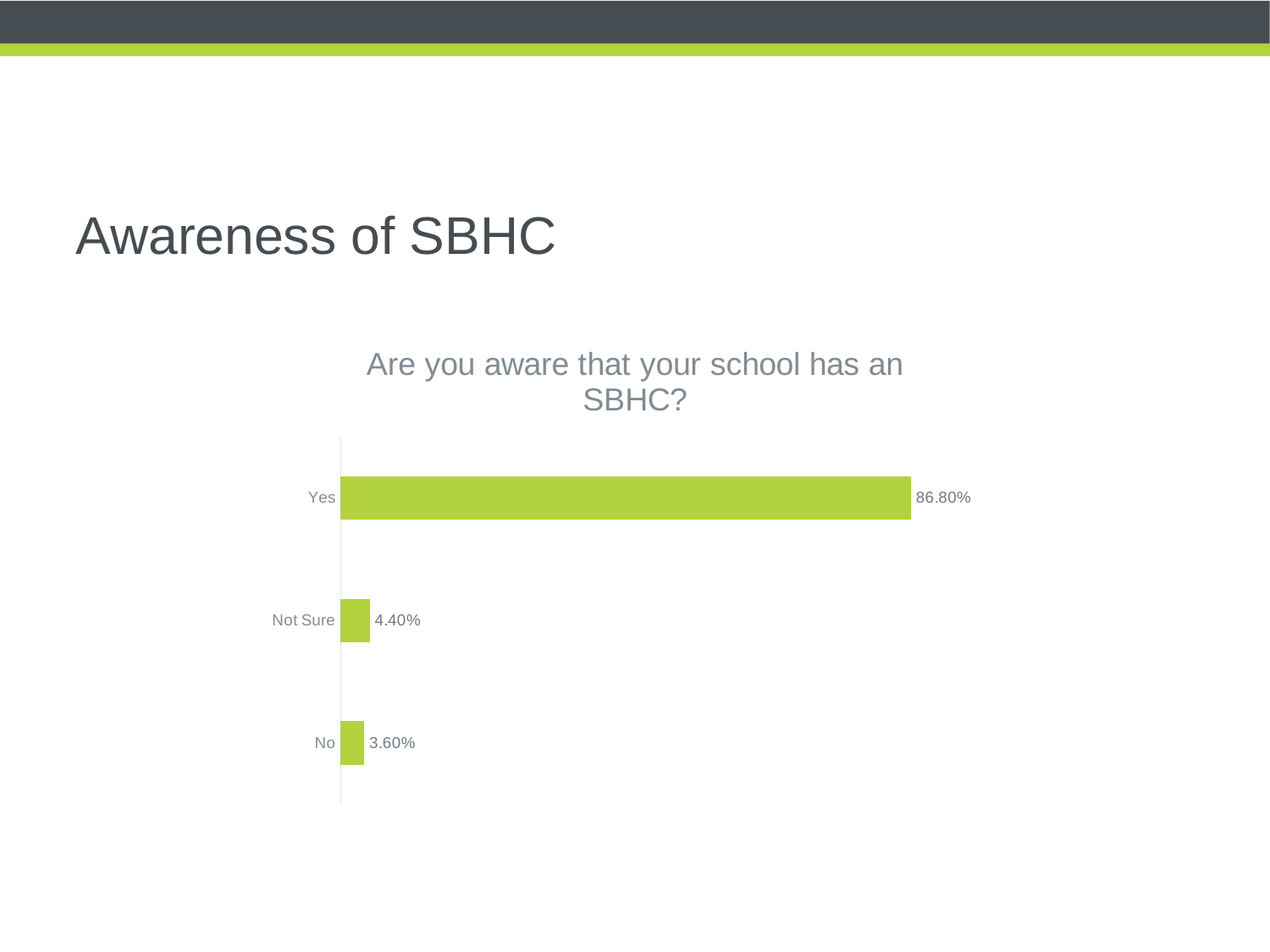
What percentage of respondents answered "Not Sure"? 4.40% How many response categories are shown in the chart? 3 Which is larger, the percentage for "Not Sure" or the percentage for "No"? Not Sure What percentage of respondents answered "No"? 3.60% What percentage of respondents answered "Yes" to being aware that their school has an SBHC? 86.80% What is the title of the chart? Are you aware that your school has an SBHC? What is the difference in percentage points between the "Not Sure" and "No" responses? 0.80% What type of chart is shown on the slide? Bar chart Which response category has the highest percentage? Yes Which response category has the lowest percentage? No What colour are the bars in the chart? Green What is the difference in percentage points between the "Yes" and "No" responses? 83.20%